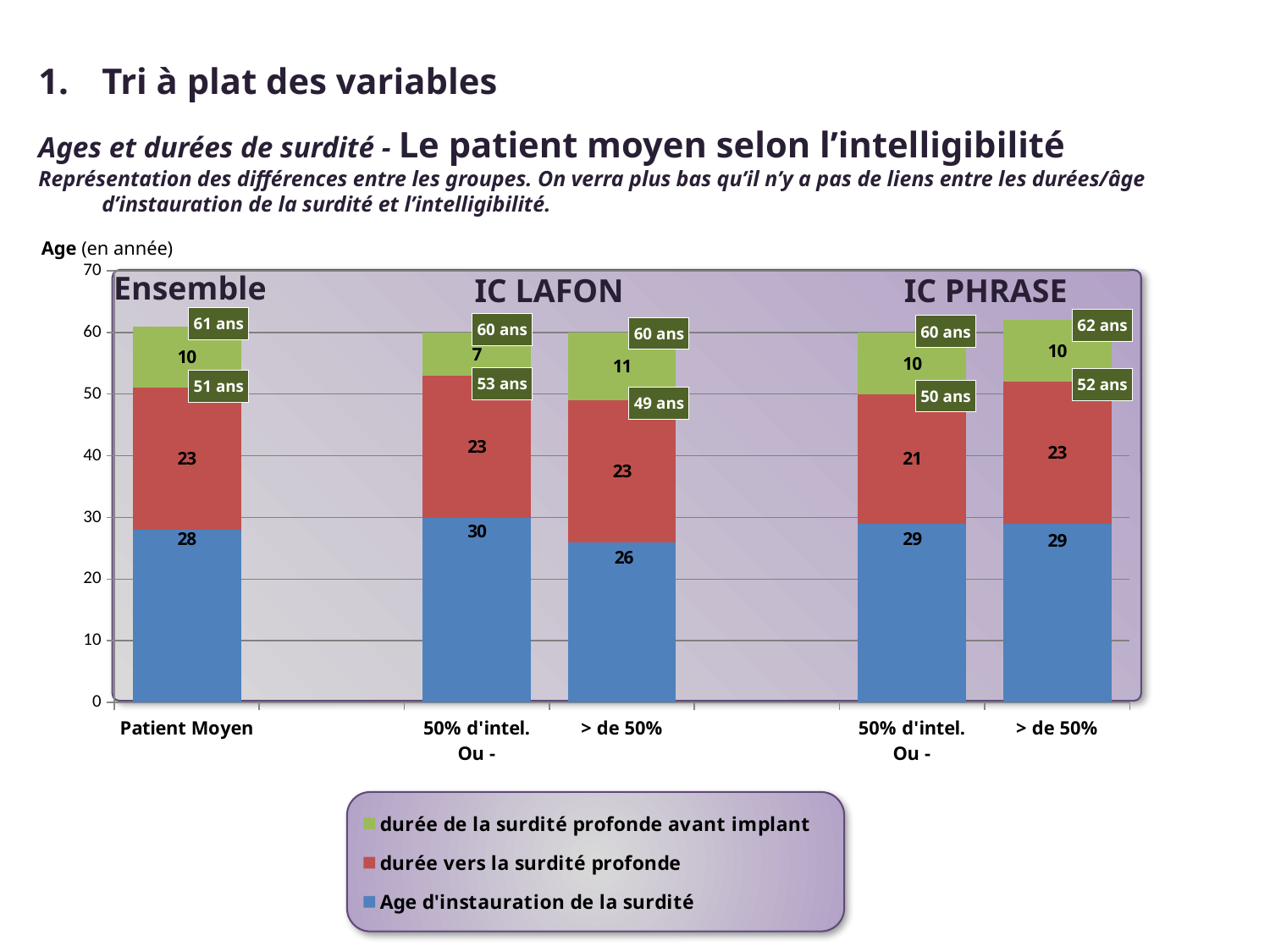
Which is larger: the 'durée vers la surdité profonde' value for IC PHRASE '50% d'intel. Ou -' or for IC PHRASE '> de 50%'? IC PHRASE > de 50% What is the value of 'durée de la surdité profonde avant implant' for the IC LAFON '50% d'intel. Ou -' bar? 7 What is the total of the stacked bar for Patient Moyen? 61 ans Which bar has the lowest 'Age d'instauration de la surdité' value? IC LAFON > de 50% What is the value of 'durée vers la surdité profonde' for the IC PHRASE '50% d'intel. Ou -' bar? 21 How many series does the legend list? 3 What type of chart is shown on the slide? stacked bar chart How many bars are plotted in the chart? 5 What is the difference between the 'Age d'instauration de la surdité' values for IC LAFON '50% d'intel. Ou -' and IC LAFON '> de 50%'? 4 Which bar has the highest 'durée de la surdité profonde avant implant' value? IC LAFON > de 50% What is the total of the stacked bar for IC PHRASE '> de 50%'? 62 ans What is the value of 'Age d'instauration de la surdité' for the Patient Moyen bar? 28